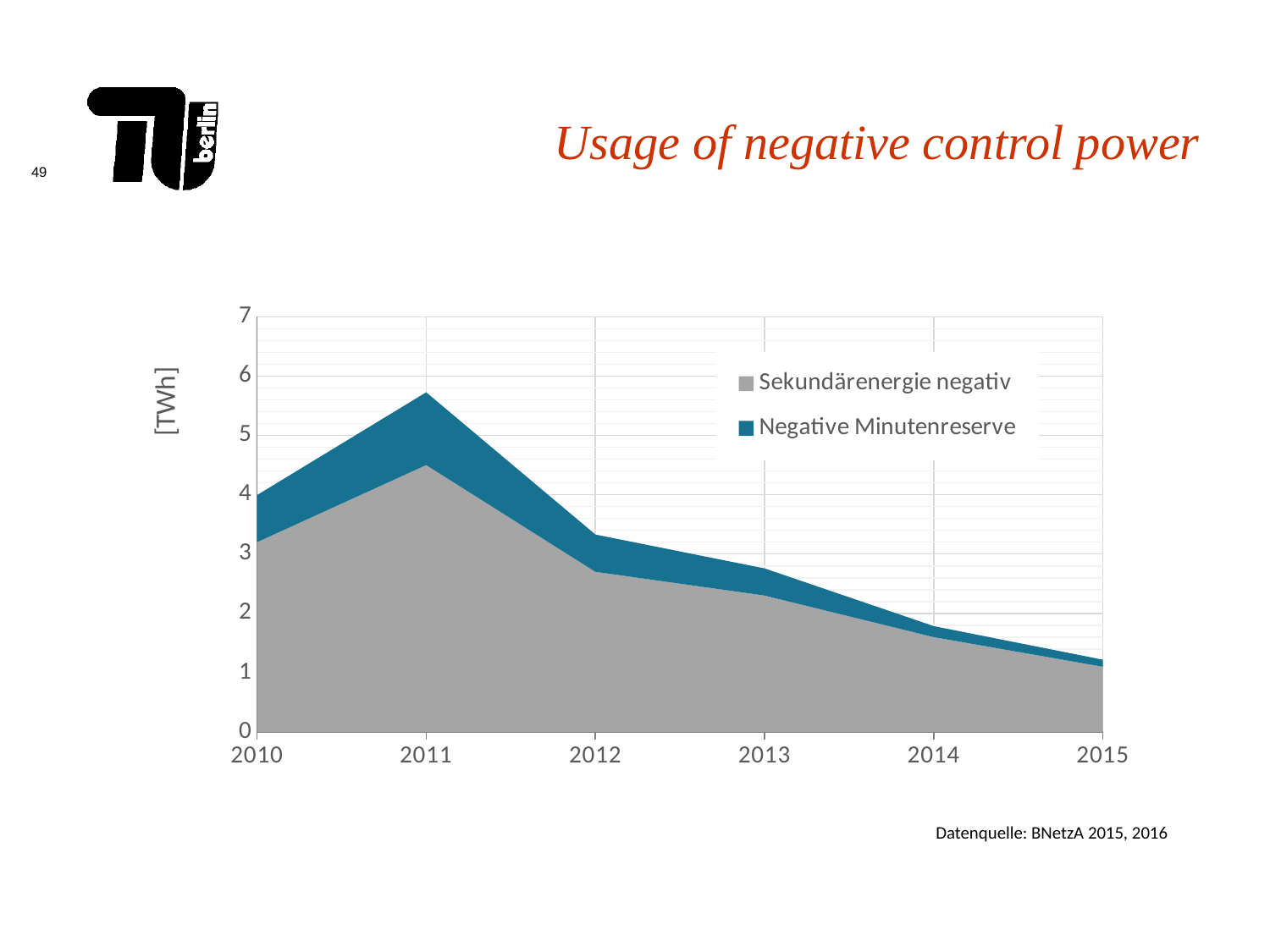
Is the value of Sekundärenergie negativ in 2011 greater or less than 4 TWh? greater Which series are listed in the legend? Sekundärenergie negativ and Negative Minutenreserve In which year is the total negative control power highest? 2011 What unit is shown on the y axis? [TWh] In 2011, which series is larger: Sekundärenergie negativ or Negative Minutenreserve? Sekundärenergie negativ How many series does the legend list? 2 Is the total value for 2015 greater or less than 2 TWh? less Is the total value for 2011 greater or less than 5 TWh? greater How many years are plotted along the x axis? 6 What kind of chart is shown on the slide? Stacked area chart Do the values rise or fall from 2011 to 2015? Fall In which year is the total negative control power lowest? 2015